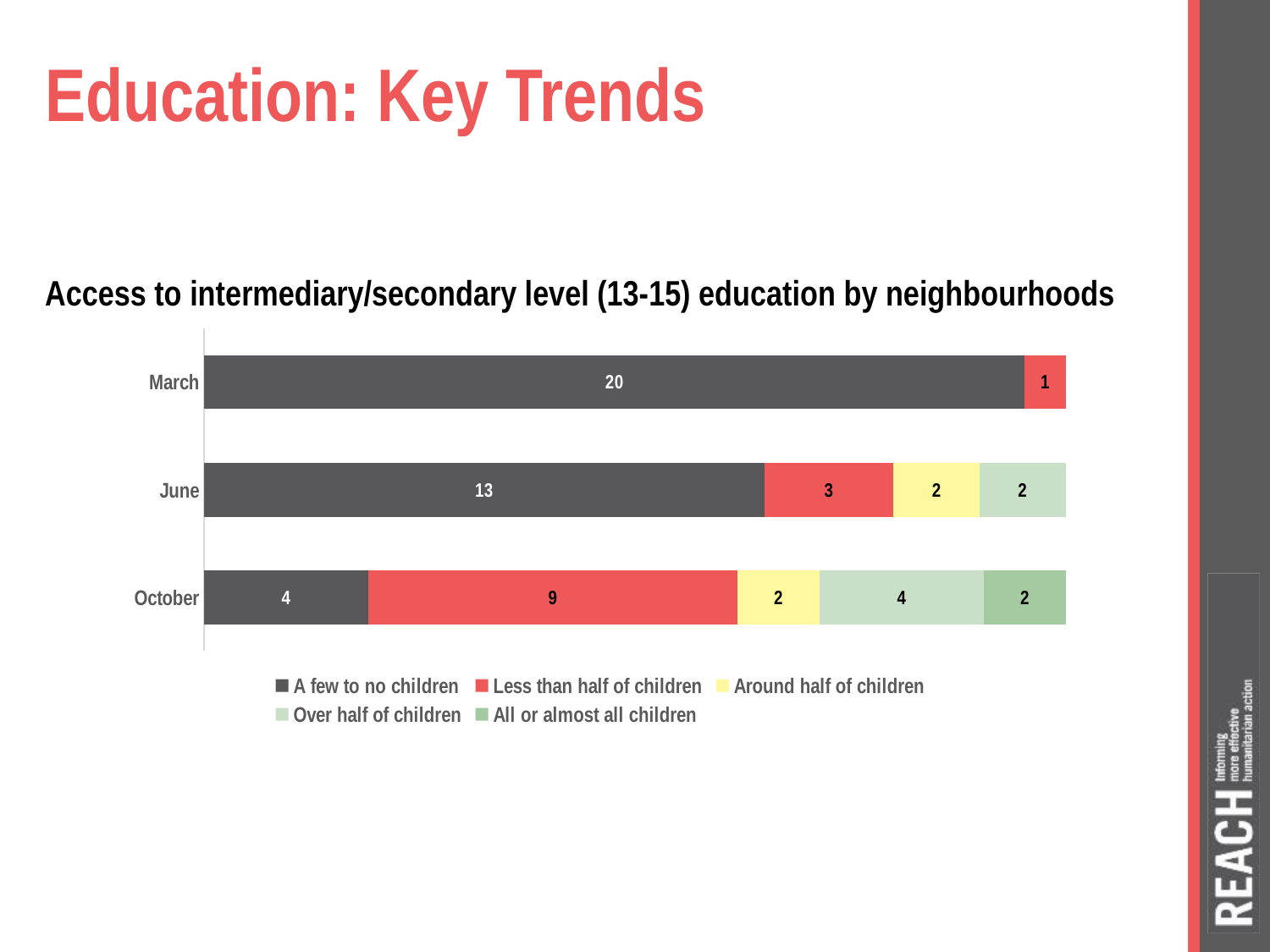
Which month has the highest value for "A few to no children"? March What is the value for "Over half of children" in June? 2 What is the difference between the "A few to no children" values for March and June? 7 How many series does the legend list? 5 What kind of chart is shown on the slide? Stacked bar chart Which is larger: the "Less than half of children" value in June or in October? October Which month has the lowest value for "A few to no children"? October How many months are shown on the chart? 3 What is the value for "All or almost all children" in October? 2 What is the value for "A few to no children" in March? 20 What is the value for "Less than half of children" in October? 9 What is the total of the stacked bar for October? 21